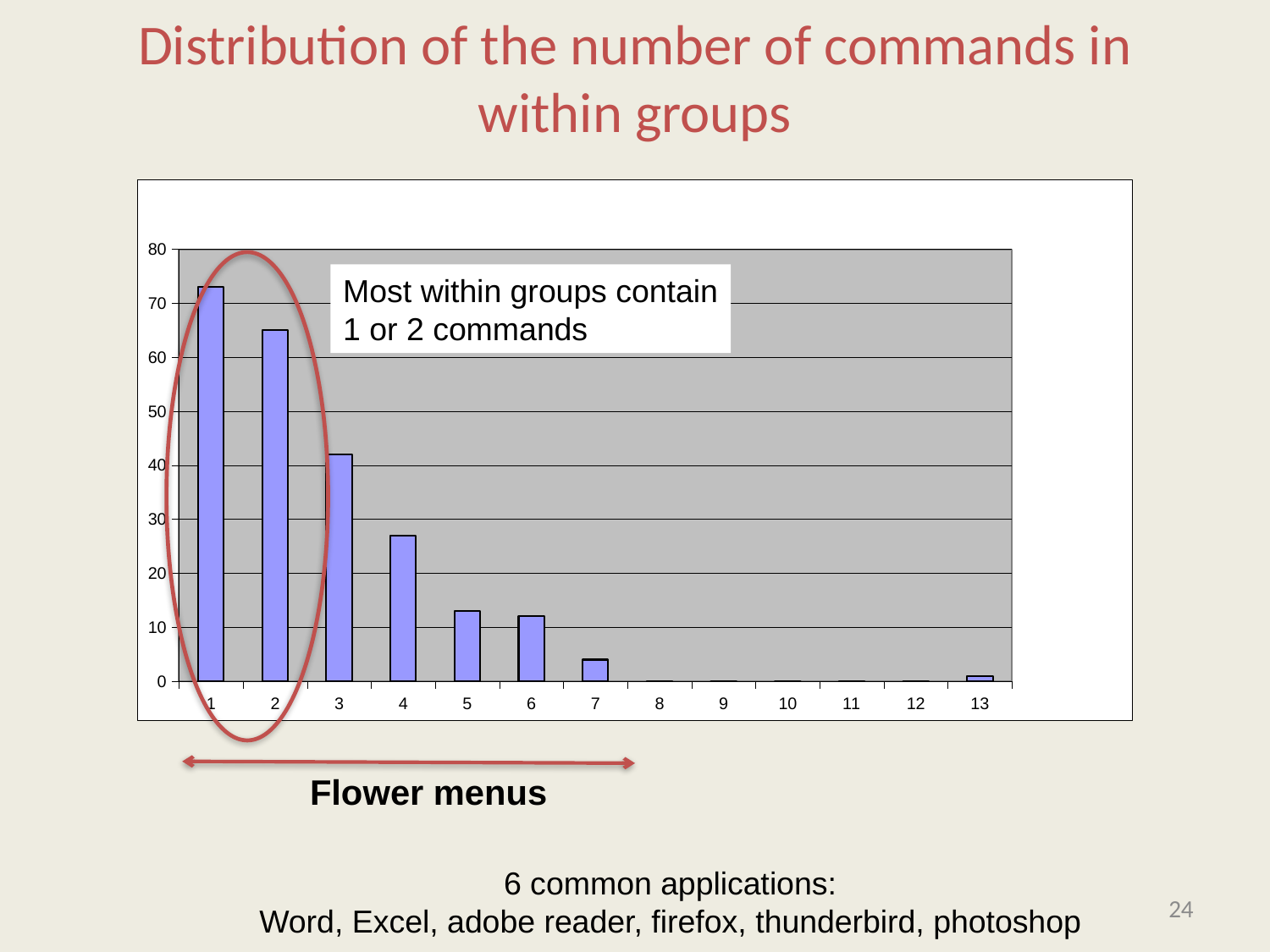
What kind of chart is shown on the slide? Bar chart Is the value for category 7 greater or less than 10? less Do the bar values generally rise or fall as the category number increases from 1 to 13? Fall Which has the larger value, category 3 or category 4? 3 Is the value for category 1 greater or less than 70? greater How many categories are shown along the x axis of the chart? 13 What does the text box inside the chart say? Most within groups contain 1 or 2 commands Is the value for category 3 greater or less than 30? greater Which has the larger value, category 1 or category 2? 1 Which category has the highest bar in the chart? 1